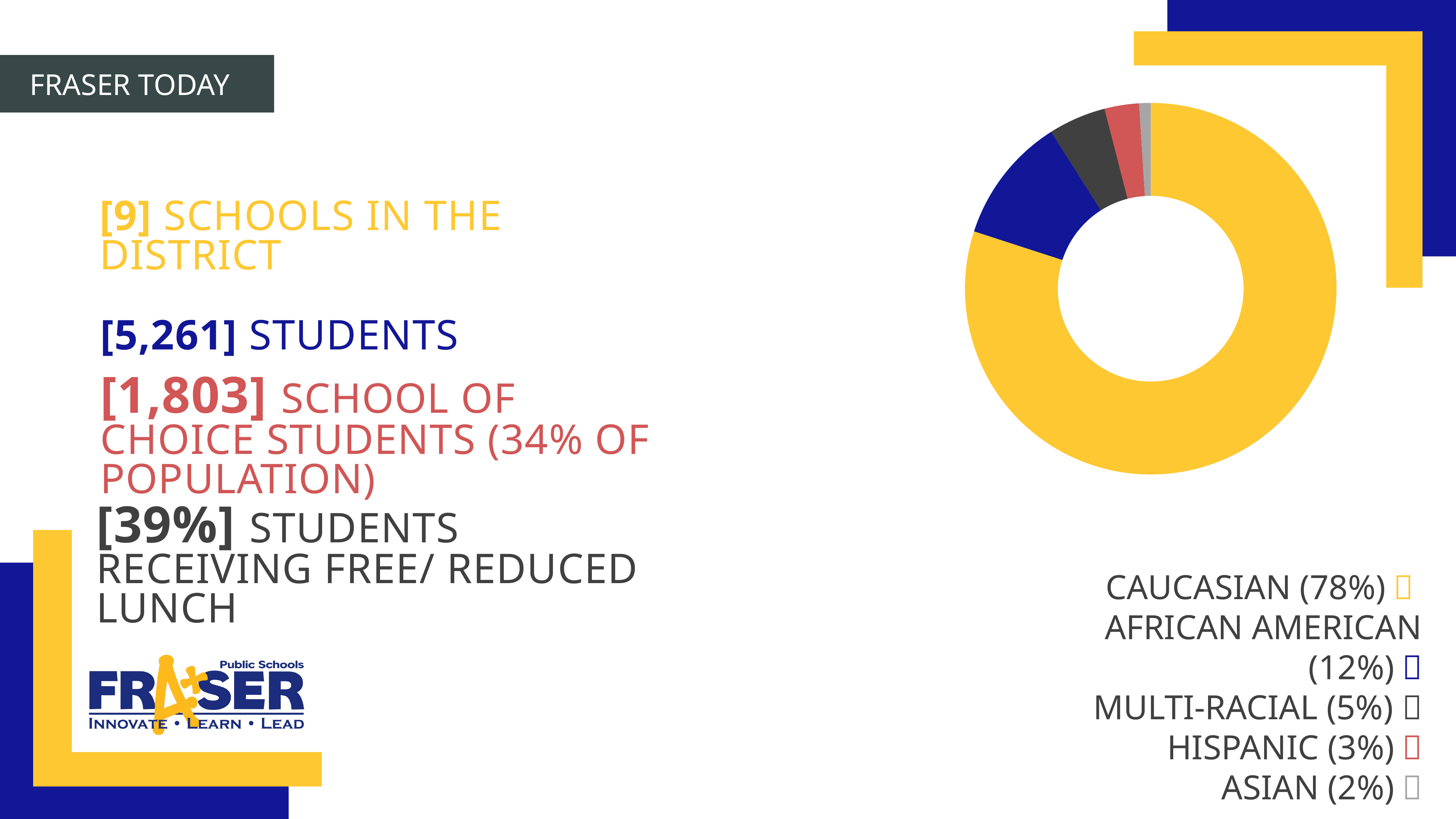
What percentage of students are Multi-Racial according to the chart legend? 5% Which group has the largest share in the chart? Caucasian What is the difference in percentage points between the Caucasian and African American shares? 66 What kind of chart is shown on the slide? Donut chart What colour represents African American in the chart? Blue Which share is larger, Multi-Racial or Hispanic? Multi-Racial What percentage of students are Asian according to the chart legend? 2% How many groups are shown in the chart legend? 5 Which group has the smallest share in the chart? Asian What percentage of students are Caucasian according to the chart legend? 78% What percentage of students are African American according to the chart legend? 12% What percentage of students are Hispanic according to the chart legend? 3%